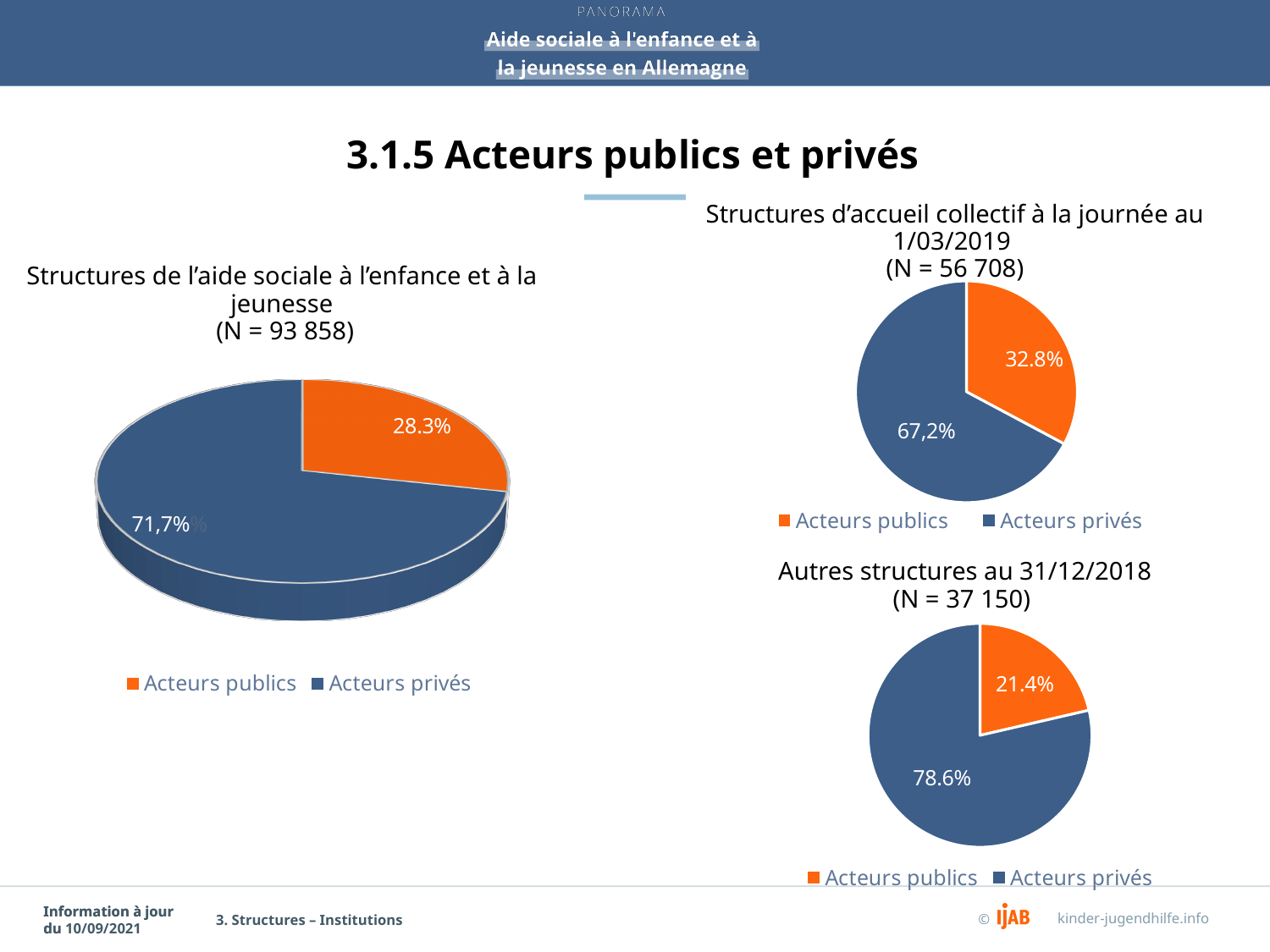
How many categories does the legend of the chart 'Structures d'accueil collectif à la journée au 1/03/2019' list? 2 In the chart 'Structures d'accueil collectif à la journée au 1/03/2019', what share is shown for Acteurs privés? 67,2% What kind of chart is 'Autres structures au 31/12/2018'? Pie chart In the chart 'Structures d'accueil collectif à la journée au 1/03/2019', what share is shown for Acteurs publics? 32.8% In the chart 'Autres structures au 31/12/2018', what share is shown for Acteurs privés? 78.6% In the chart 'Structures d'accueil collectif à la journée au 1/03/2019', which category has the smallest slice? Acteurs publics In the chart 'Structures de l'aide sociale à l'enfance et à la jeunesse', which is larger: Acteurs publics or Acteurs privés? Acteurs privés In the chart 'Structures de l'aide sociale à l'enfance et à la jeunesse', what share is shown for Acteurs privés? 71,7% What is the N value given in the title of the chart 'Autres structures au 31/12/2018'? 37 150 In the chart 'Structures de l'aide sociale à l'enfance et à la jeunesse', what share is shown for Acteurs publics? 28.3% In the chart 'Autres structures au 31/12/2018', what share is shown for Acteurs publics? 21.4% In the chart 'Autres structures au 31/12/2018', which category has the largest slice? Acteurs privés